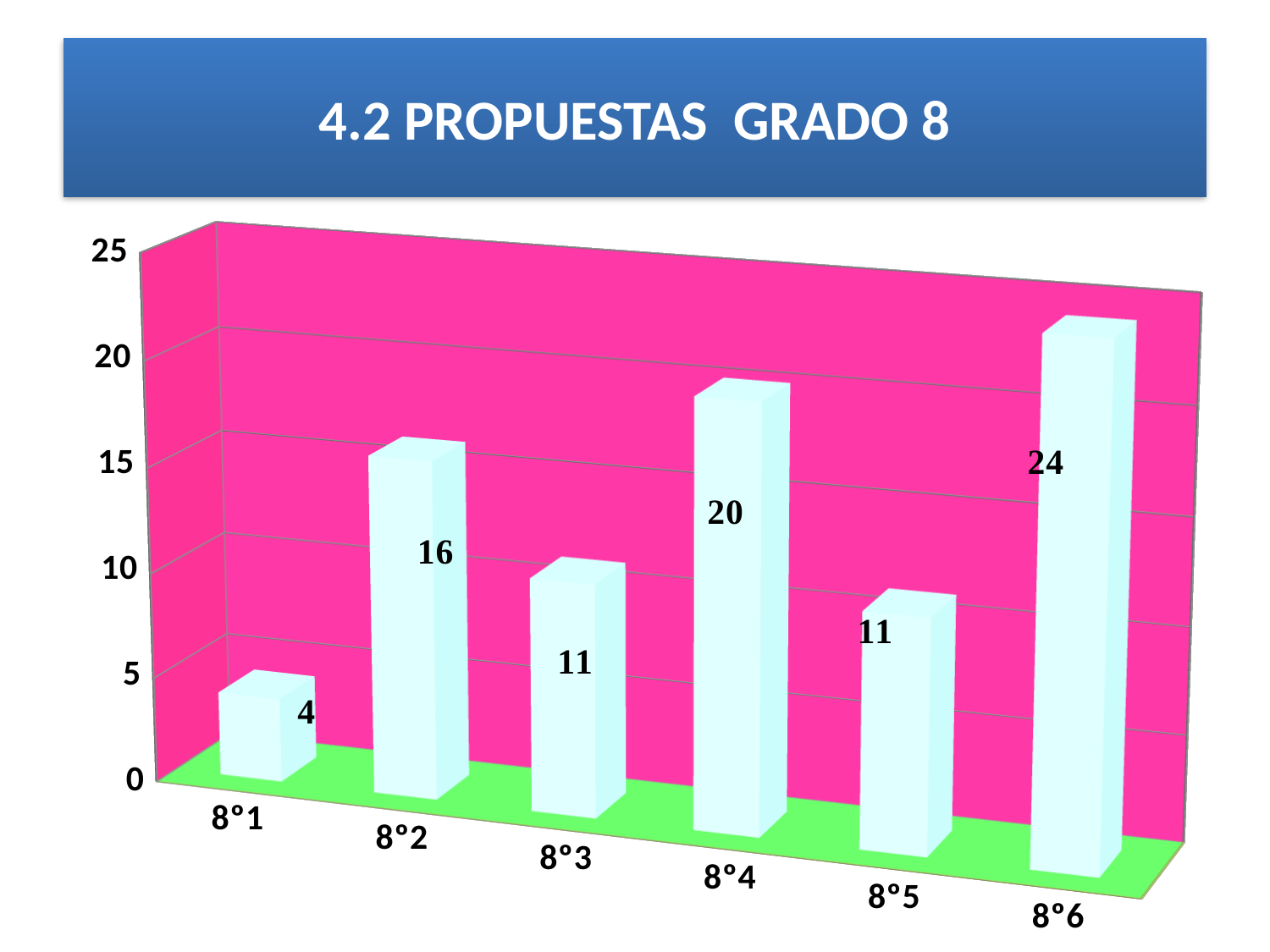
Which category has the lowest value? 8°1 What is the value for 8°1? 4 What is the difference between the values for 8°2 and 8°3? 5 What is the difference between the values for 8°6 and 8°1? 20 Which is larger, the value for 8°2 or the value for 8°5? 8°2 Which category has the highest value? 8°6 Is the value for 8°4 greater or less than 15? greater How many categories are shown on the x axis? 6 What is the value for 8°6? 24 What is the title of the slide? 4.2 PROPUESTAS GRADO 8 What kind of chart is shown on the slide? bar chart What is the value for 8°4? 20